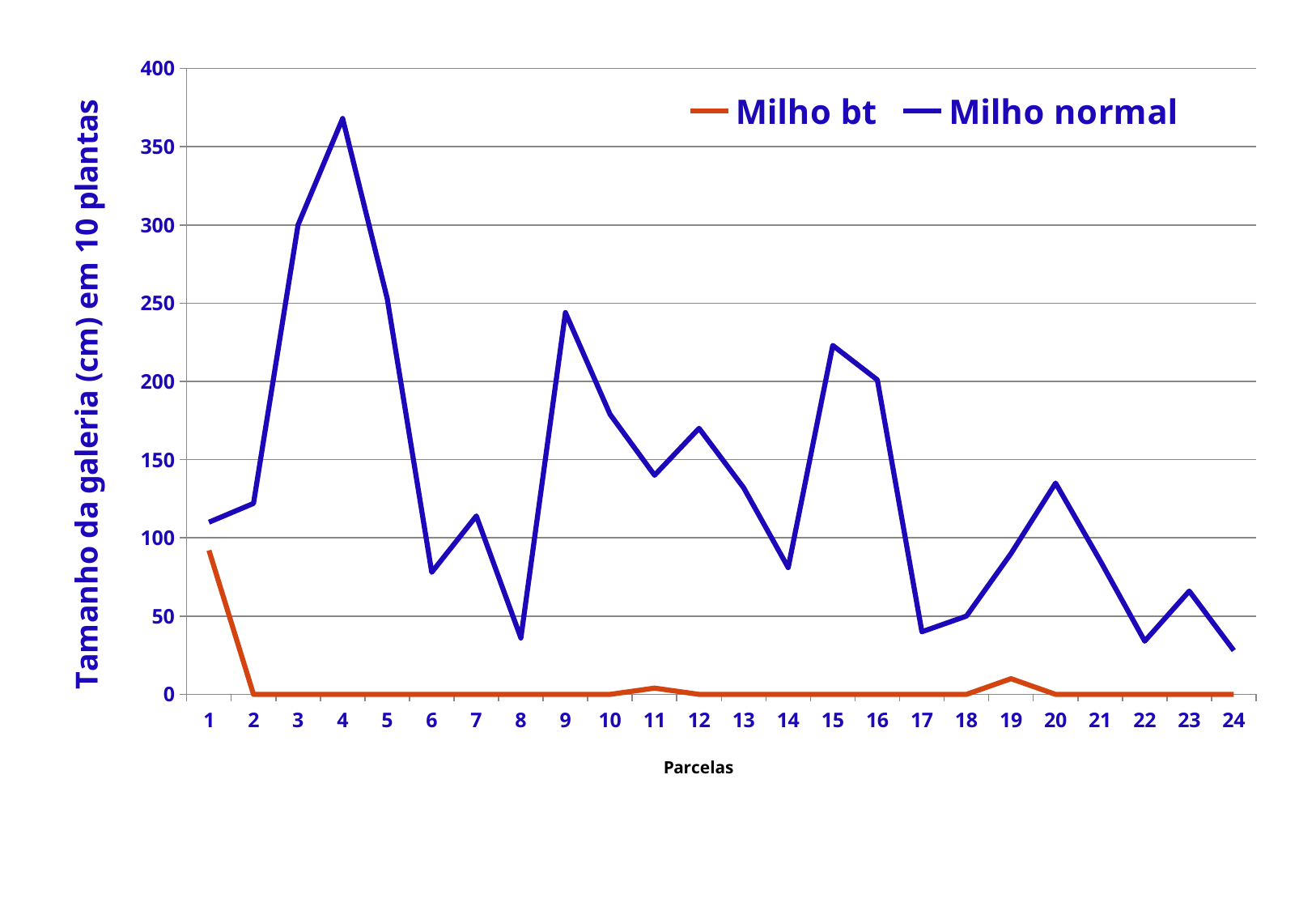
How many parcelas (categories) are shown on the x axis? 24 At which parcela does the Milho normal series reach its highest value? 4 For Milho normal, which is larger: the value at parcela 14 or at parcela 15? parcela 15 At parcela 1, which series has the higher value, Milho bt or Milho normal? Milho normal At which parcela does the Milho bt series reach its highest value? 1 Is the value for Milho normal at parcela 6 greater or less than 100? less What kind of chart is shown on the slide? line chart Does the Milho bt series rise or fall from parcela 1 to parcela 2? fall What is the title of the y axis? Tamanho da galeria (cm) em 10 plantas Is the value for Milho normal at parcela 9 greater or less than 200? greater How many series does the legend list? 2 Is the value for Milho normal at parcela 4 greater or less than 350? greater